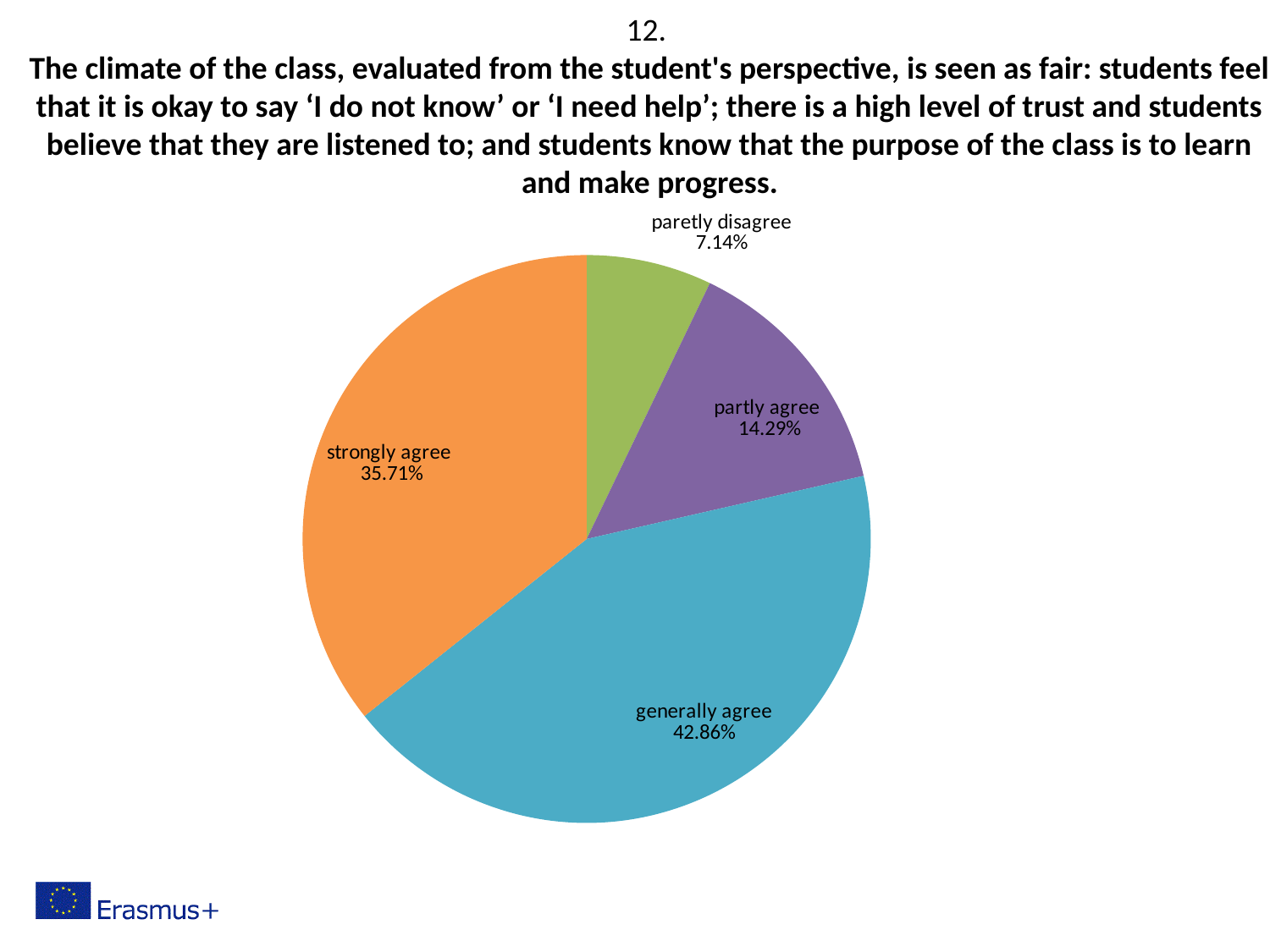
What share of the pie is labelled 'partly agree'? 14.29% What share of the pie is labelled 'strongly agree'? 35.71% Which slice of the pie is the smallest? paretly disagree What share of the pie is labelled 'paretly disagree'? 7.14% What kind of chart is shown on the slide? pie chart What is the difference in percentage points between the 'generally agree' and 'strongly agree' slices? 7.15 Which is larger, the 'strongly agree' slice or the 'partly agree' slice? strongly agree What colour is the 'generally agree' slice? blue What is the difference in percentage points between the 'partly agree' and 'paretly disagree' slices? 7.15 How many slices does the pie chart have? 4 Which slice of the pie is the largest? generally agree